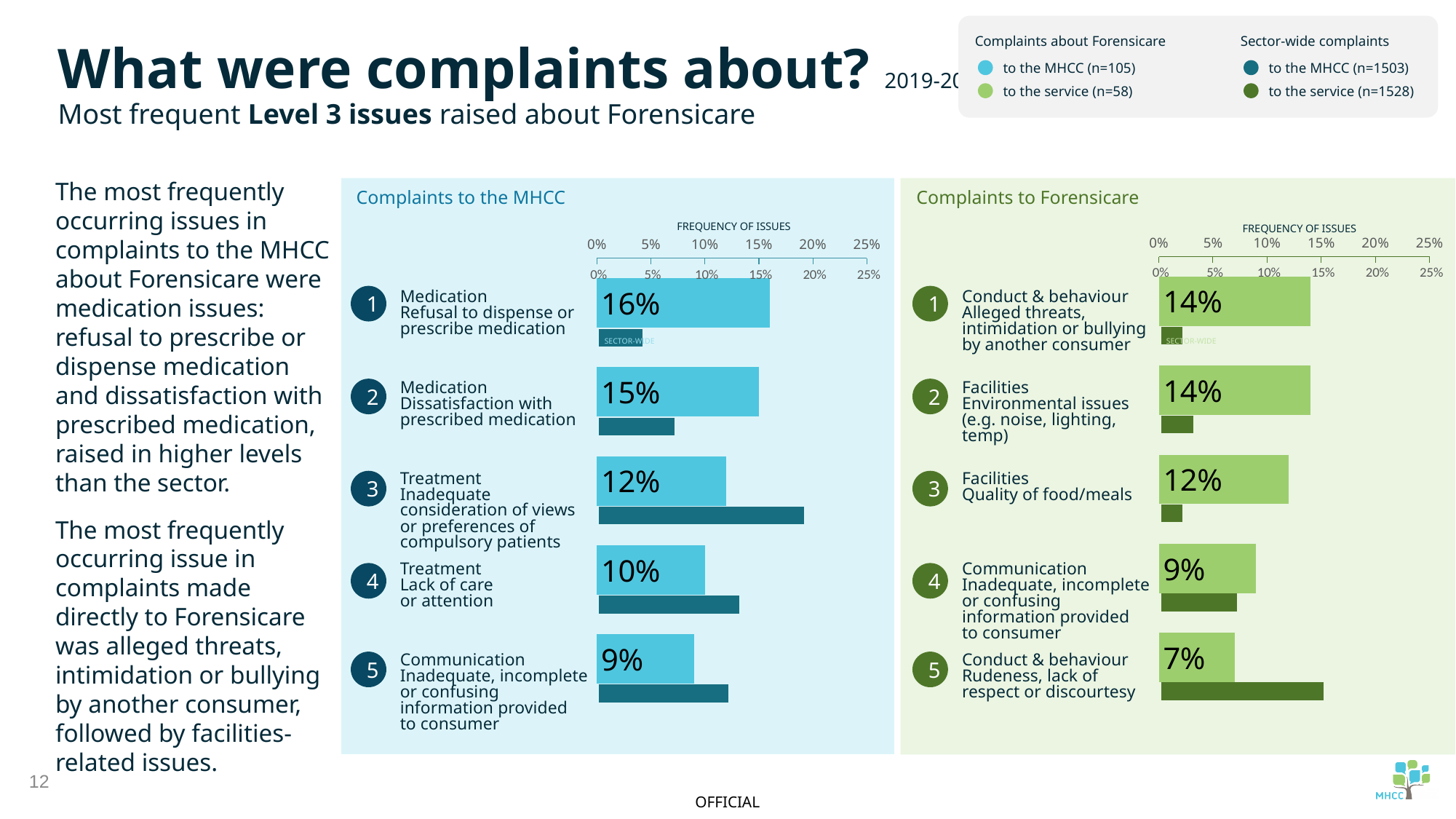
On the 'Complaints to Forensicare' chart, which issue has the lowest frequency? Conduct & behaviour – Rudeness, lack of respect or discourtesy Which is larger: the frequency for 'Medication – Dissatisfaction with prescribed medication' on the 'Complaints to the MHCC' chart, or the frequency for 'Facilities – Environmental issues' on the 'Complaints to Forensicare' chart? Medication – Dissatisfaction with prescribed medication (15%) How many issues are listed on the 'Complaints to Forensicare' chart? 5 On the 'Complaints to the MHCC' chart, is the sector-wide value for 'Treatment – Inadequate consideration of views or preferences of compulsory patients' greater or less than 15%? greater On the 'Complaints to Forensicare' chart, what is the frequency of issues for 'Facilities – Quality of food/meals'? 12% On the 'Complaints to the MHCC' chart, what is the frequency of issues for 'Medication – Refusal to dispense or prescribe medication'? 16% What type of chart is the 'Complaints to the MHCC' chart? Bar chart On the 'Complaints to the MHCC' chart, which issue has the highest frequency? Medication – Refusal to dispense or prescribe medication On the 'Complaints to the MHCC' chart, what is the difference between the frequency for 'Medication – Refusal to dispense or prescribe medication' and 'Communication – Inadequate, incomplete or confusing information provided to consumer'? 7 percentage points How many entries does the legend at the top right of the slide list? 4 On the 'Complaints to Forensicare' chart, what is the difference between the frequency for 'Conduct & behaviour – Alleged threats, intimidation or bullying by another consumer' and 'Conduct & behaviour – Rudeness, lack of respect or discourtesy'? 7 percentage points